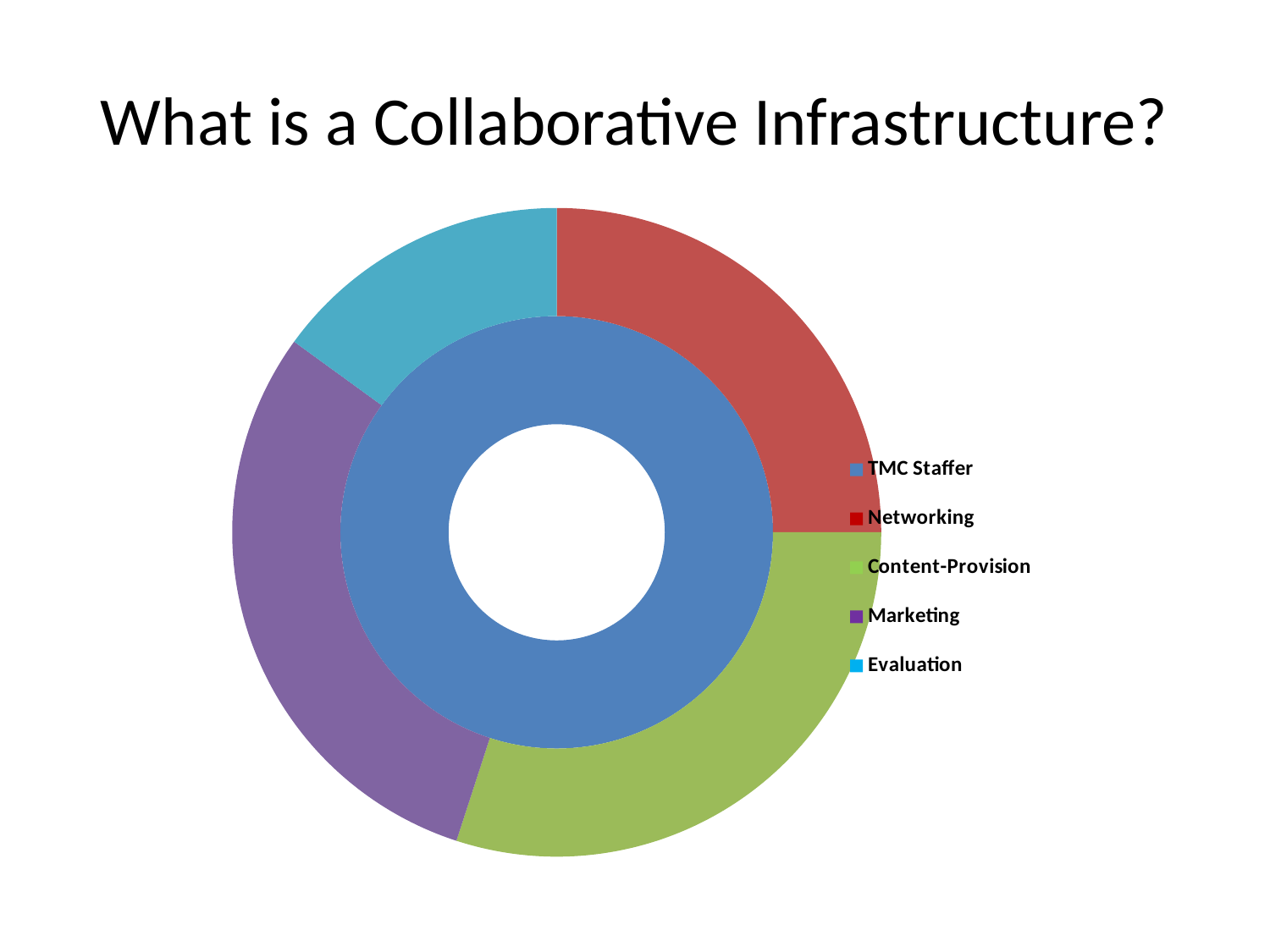
How many segments make up the outer ring of the chart? 4 Which legend entry fills the entire inner ring of the chart? TMC Staffer How many entries does the chart's legend list? 5 Which is larger in the outer ring, Networking or Evaluation? Networking What kind of chart is shown on the slide? Doughnut chart Which is larger in the outer ring, Marketing or Evaluation? Marketing Which legend entry is the smallest segment of the outer ring? Evaluation What is the title of the slide containing the chart? What is a Collaborative Infrastructure?